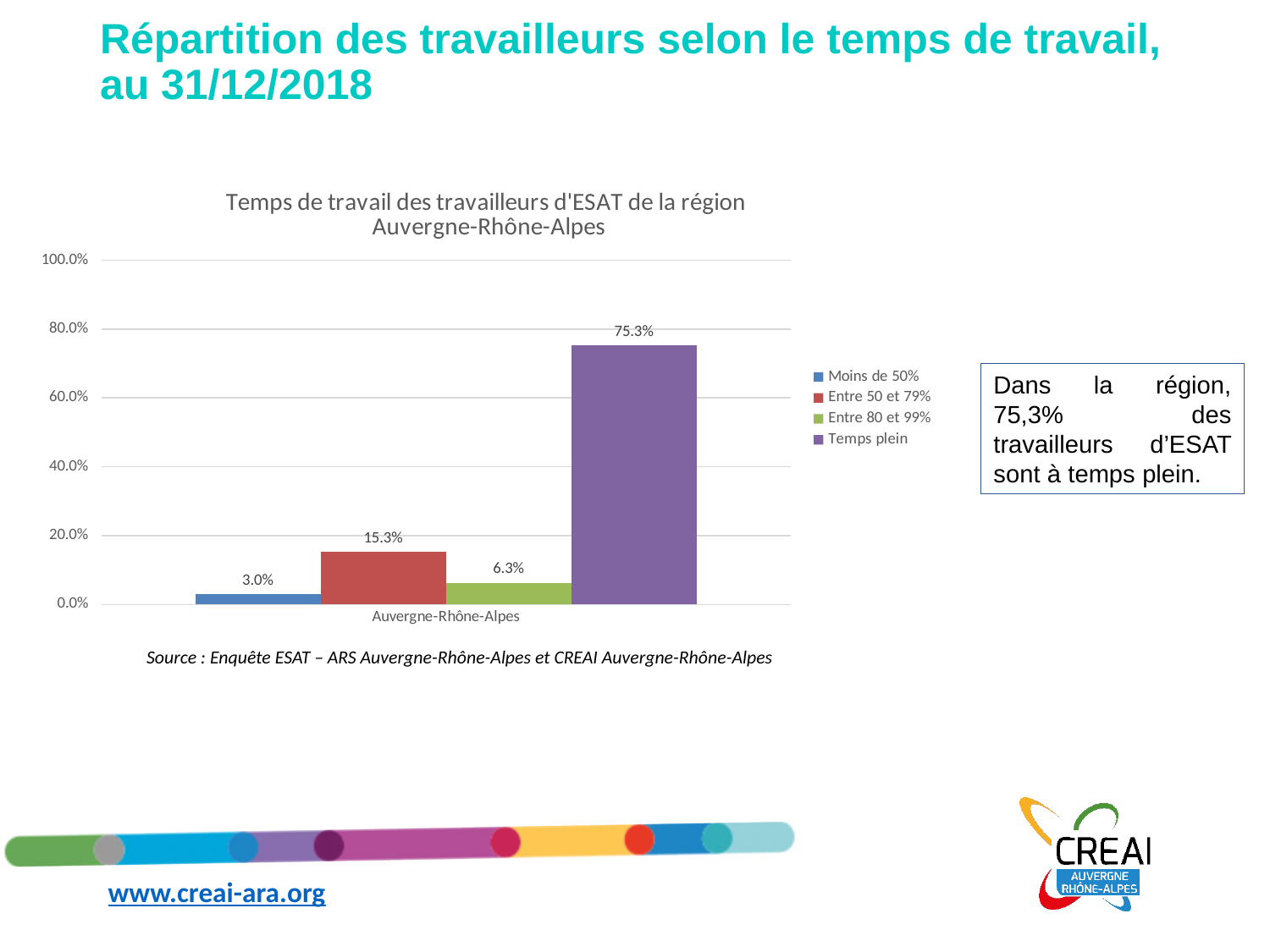
Which is larger, the value for 'Entre 50 et 79%' or the value for 'Entre 80 et 99%'? Entre 50 et 79% Is the value for 'Temps plein' greater or less than 60.0%? greater What kind of chart is shown on the slide? Bar chart What is the value for the 'Moins de 50%' series? 3.0% Which series has the lowest value? Moins de 50% What is the difference between the 'Temps plein' value and the 'Entre 50 et 79%' value? 60.0% What is the value for the 'Temps plein' series? 75.3% What is the value for the 'Entre 80 et 99%' series? 6.3% What is the title of the chart? Temps de travail des travailleurs d'ESAT de la région Auvergne-Rhône-Alpes Which series has the highest value? Temps plein What is the value for the 'Entre 50 et 79%' series? 15.3% How many series does the legend list? 4